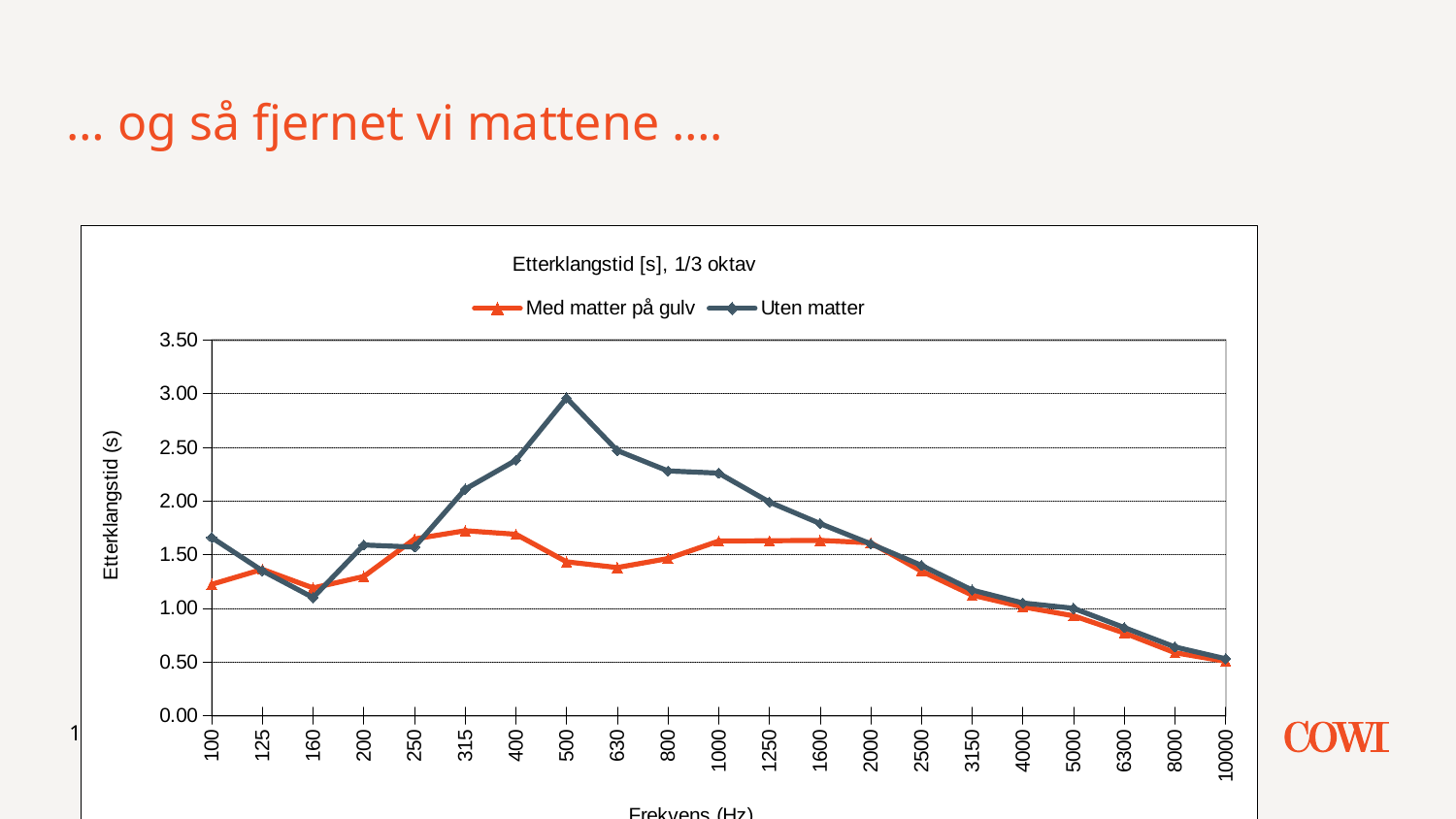
Is the value for 'Uten matter' at 160 Hz greater or less than 1.50? less How many frequency categories are shown on the x axis? 21 At 1250 Hz, which series has the higher value, 'Med matter på gulv' or 'Uten matter'? Uten matter Do the values for 'Uten matter' rise or fall from 2000 Hz to 10000 Hz? fall At which frequency does the 'Uten matter' series reach its highest value? 500 Is the value for 'Med matter på gulv' at 315 Hz greater or less than 1.50? greater How many series does the legend list? 2 Is the value for 'Uten matter' at 500 Hz greater or less than 2.50? greater What is the title of the chart? Etterklangstid [s], 1/3 oktav What kind of chart is shown on the slide? line chart At which frequency does the 'Uten matter' series reach its lowest value? 10000